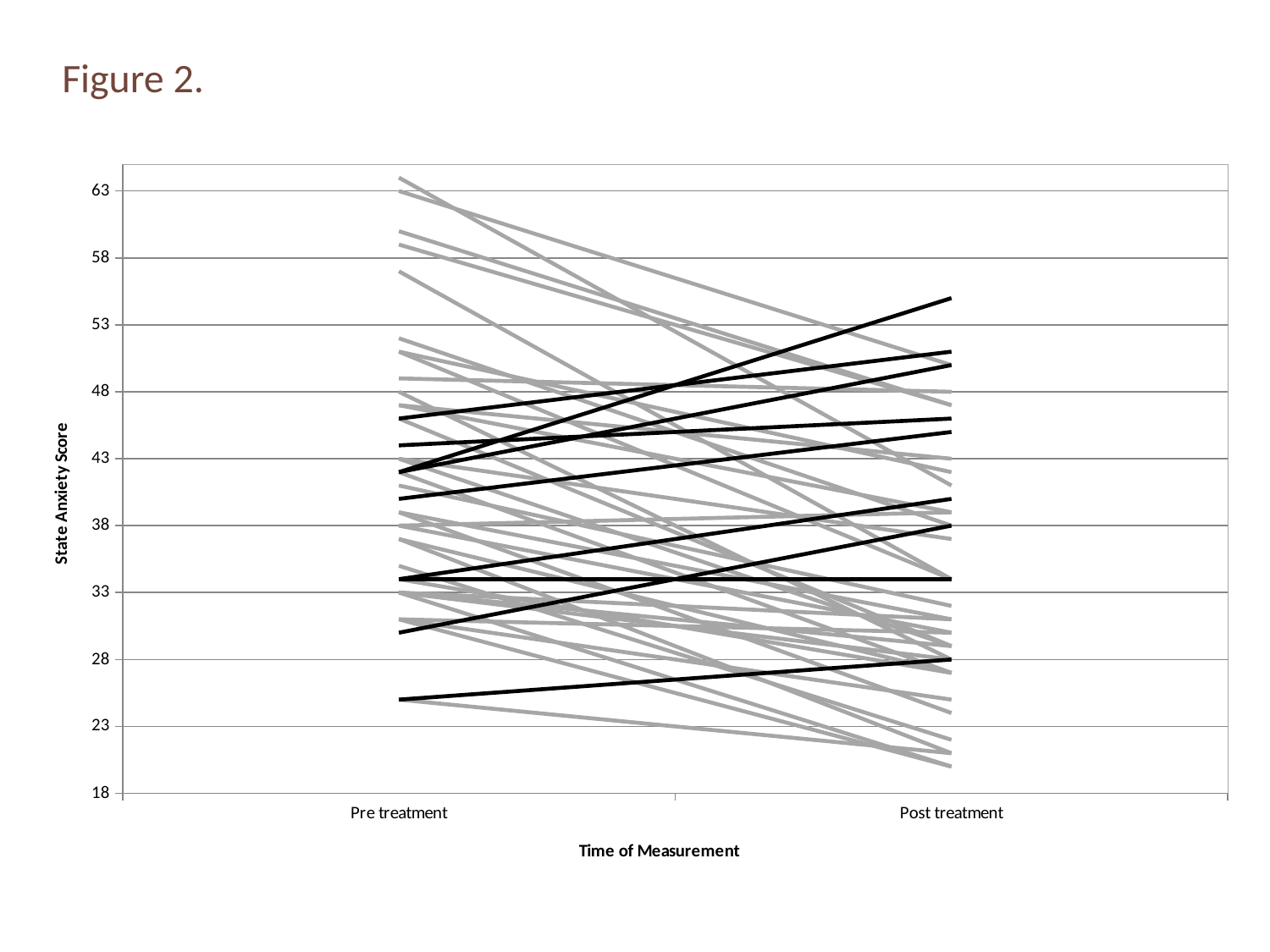
Do the black lines generally rise or fall from Pre treatment to Post treatment? rise Do most of the gray lines rise or fall from Pre treatment to Post treatment? fall What is the title of the y axis? State Anxiety Score What are the two categories labelled on the x axis? Pre treatment, Post treatment Is the highest Post treatment score greater or less than 53? greater Is the lowest Post treatment score greater or less than 23? less How many time points are shown on the x axis? 2 Is the highest Pre treatment score greater or less than 58? greater What kind of chart is shown on the slide? line chart What is the title of the x axis? Time of Measurement What is the lowest value shown on the y axis? 18